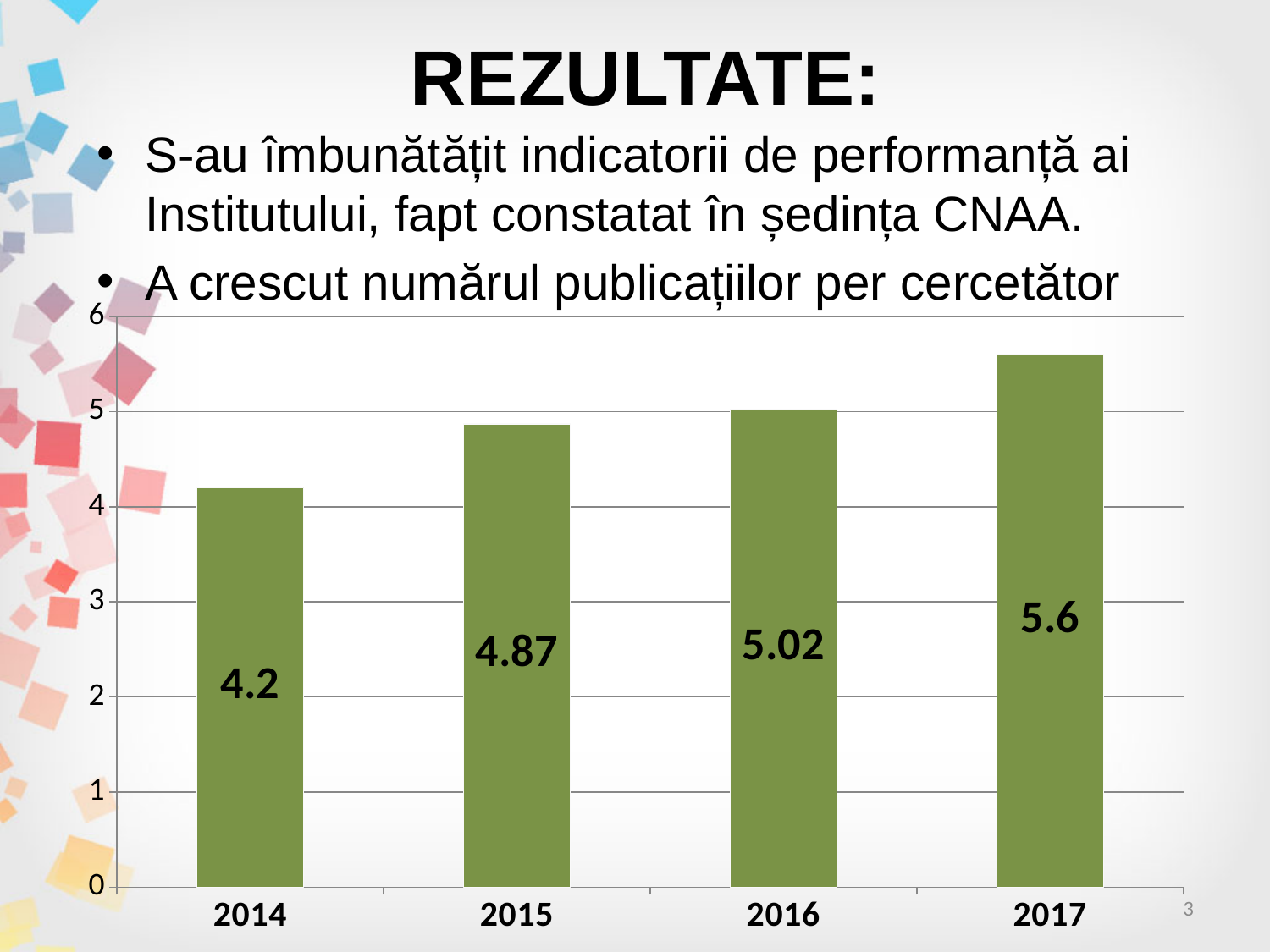
Which is larger, the value for 2015 or the value for 2016? 2016 What is the value for 2014? 4.2 What is the difference between the values for 2017 and 2014? 1.4 What kind of chart is shown on the slide? bar chart Which year has the lowest value? 2014 Is the value for 2015 greater or less than 5? less Do the values rise or fall from 2014 to 2017? rise What is the value for 2016? 5.02 How many years are shown on the x axis? 4 What is the value for 2017? 5.6 What is the value for 2015? 4.87 Which year has the highest value? 2017